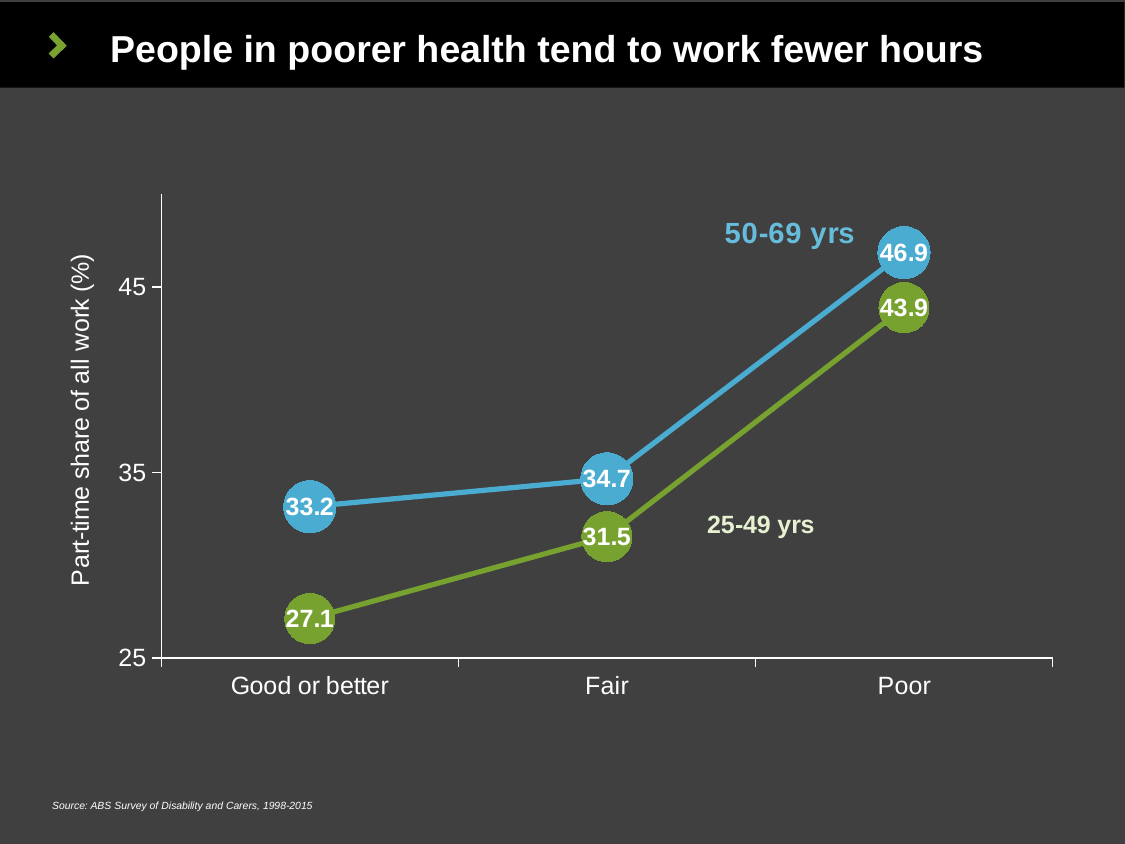
What is the part-time share of all work for the 25-49 yrs group with Good or better health? 27.1 Which series has the larger value at Fair health, 50-69 yrs or 25-49 yrs? 50-69 yrs Is the value for the 25-49 yrs group at Poor health greater or less than 45? less Which health category has the highest part-time share for the 50-69 yrs series? Poor How many series are plotted on the chart? 2 What is the difference between the 50-69 yrs and 25-49 yrs values at Poor health? 3.0 What is the difference between the 50-69 yrs and 25-49 yrs values at Good or better health? 6.1 What is the value for the 25-49 yrs series at Fair health? 31.5 How many health categories are shown on the x axis? 3 Which health category has the lowest part-time share for the 25-49 yrs series? Good or better What is the part-time share of all work for the 50-69 yrs group with Poor health? 46.9 Do the values for the 25-49 yrs series rise or fall from Good or better to Poor health? rise